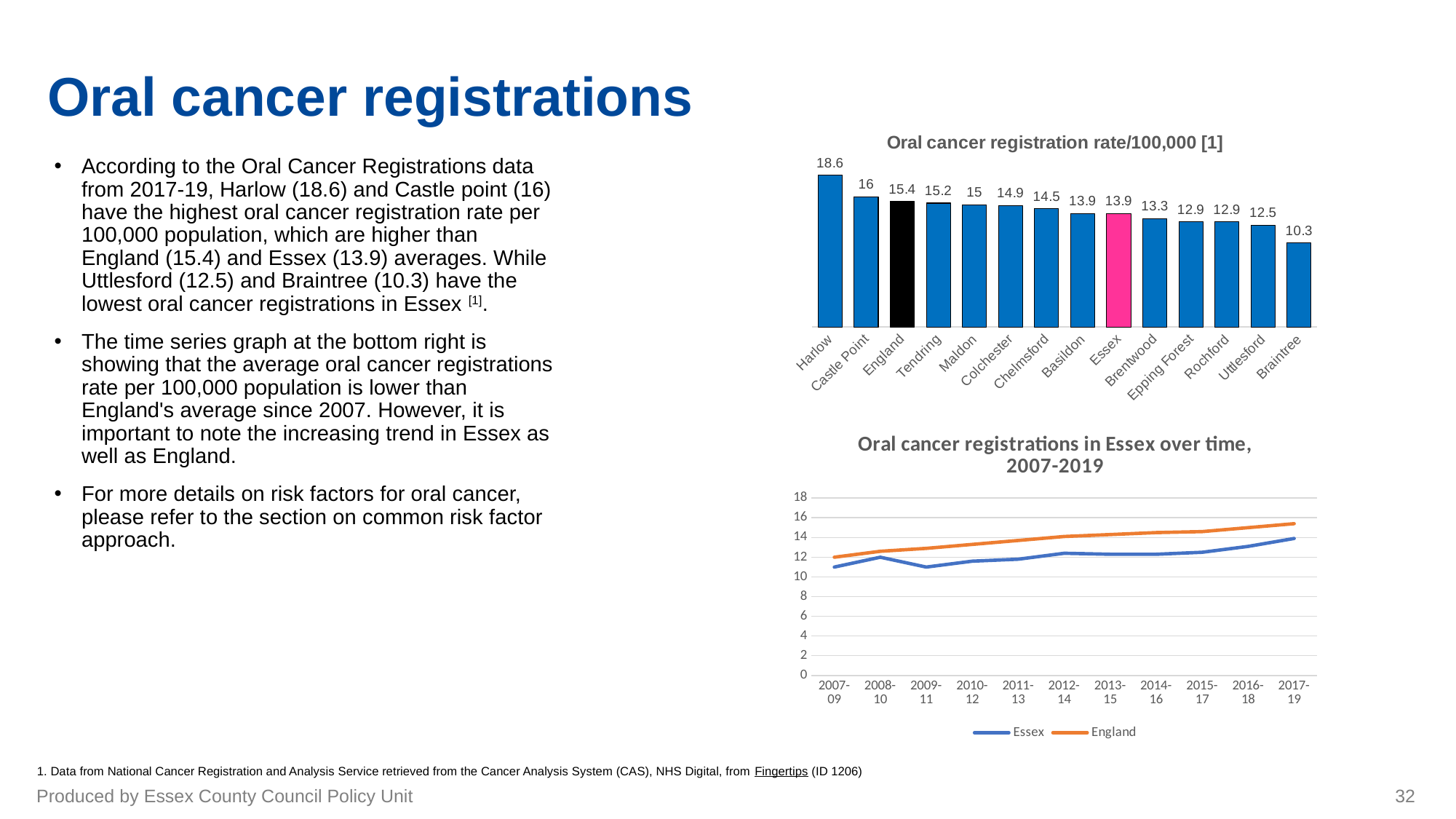
How many areas are shown in the 'Oral cancer registration rate/100,000 [1]' bar chart? 14 In the 'Oral cancer registration rate/100,000 [1]' chart, which bar is coloured pink? Essex In the 'Oral cancer registration rate/100,000 [1]' chart, which area has the highest rate? Harlow In the 'Oral cancer registrations in Essex over time, 2007-2019' chart, is the England value for 2017-19 greater or less than 14? greater In the 'Oral cancer registration rate/100,000 [1]' chart, which is larger, Castle Point or Tendring? Castle Point In the 'Oral cancer registration rate/100,000 [1]' chart, what is the value for England? 15.4 What type of chart is 'Oral cancer registration rate/100,000 [1]'? Bar chart In the 'Oral cancer registration rate/100,000 [1]' chart, what is the difference between Harlow and Braintree? 8.3 How many series does the legend list in the 'Oral cancer registrations in Essex over time, 2007-2019' chart? 2 In the 'Oral cancer registration rate/100,000 [1]' chart, which area has the lowest rate? Braintree In the 'Oral cancer registrations in Essex over time, 2007-2019' chart, does the England line rise or fall from 2007-09 to 2017-19? Rise In the 'Oral cancer registration rate/100,000 [1]' chart, what is the value for Harlow? 18.6